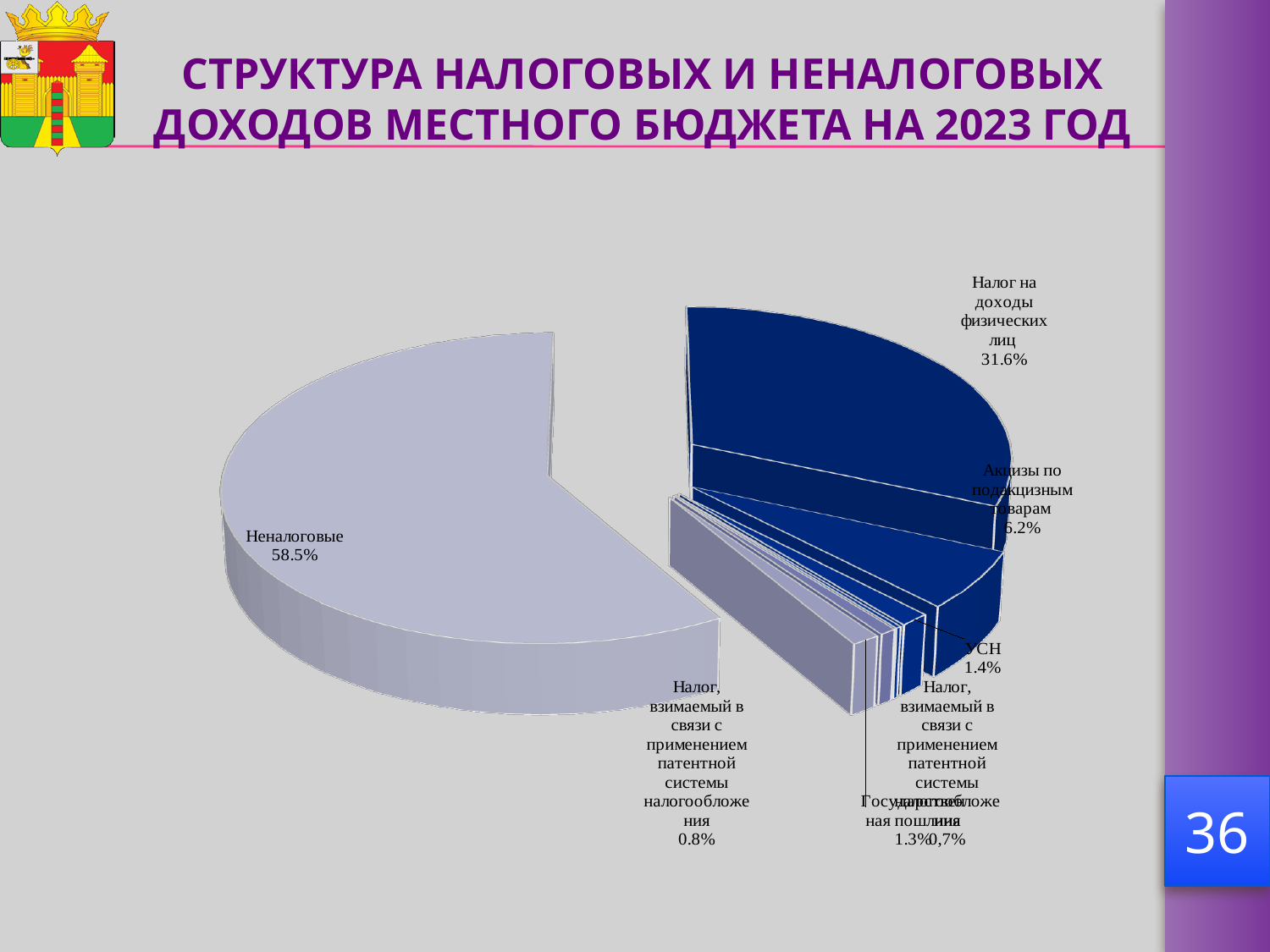
What share of the pie is labelled "Государственная пошлина"? 1.3% What kind of chart is shown on the slide? pie chart What is the title of the slide containing the chart? СТРУКТУРА НАЛОГОВЫХ И НЕНАЛОГОВЫХ ДОХОДОВ МЕСТНОГО БЮДЖЕТА НА 2023 ГОД What share of the pie is labelled "Неналоговые"? 58.5% What share of the pie is labelled "Налог на доходы физических лиц"? 31.6% Which slice of the pie is the largest? Неналоговые What share of the pie is labelled "Акцизы по подакцизным товарам"? 6.2% What is the difference in percentage points between the "Неналоговые" share and the "Налог на доходы физических лиц" share? 26.9 Which is larger: the share for "Налог на доходы физических лиц" or the share for "Акцизы по подакцизным товарам"? Налог на доходы физических лиц What share of the pie is labelled "УСН"? 1.4% What is the difference in percentage points between the "Акцизы по подакцизным товарам" share and the "УСН" share? 4.8 Which is larger: the share for "УСН" or the share for "Государственная пошлина"? УСН